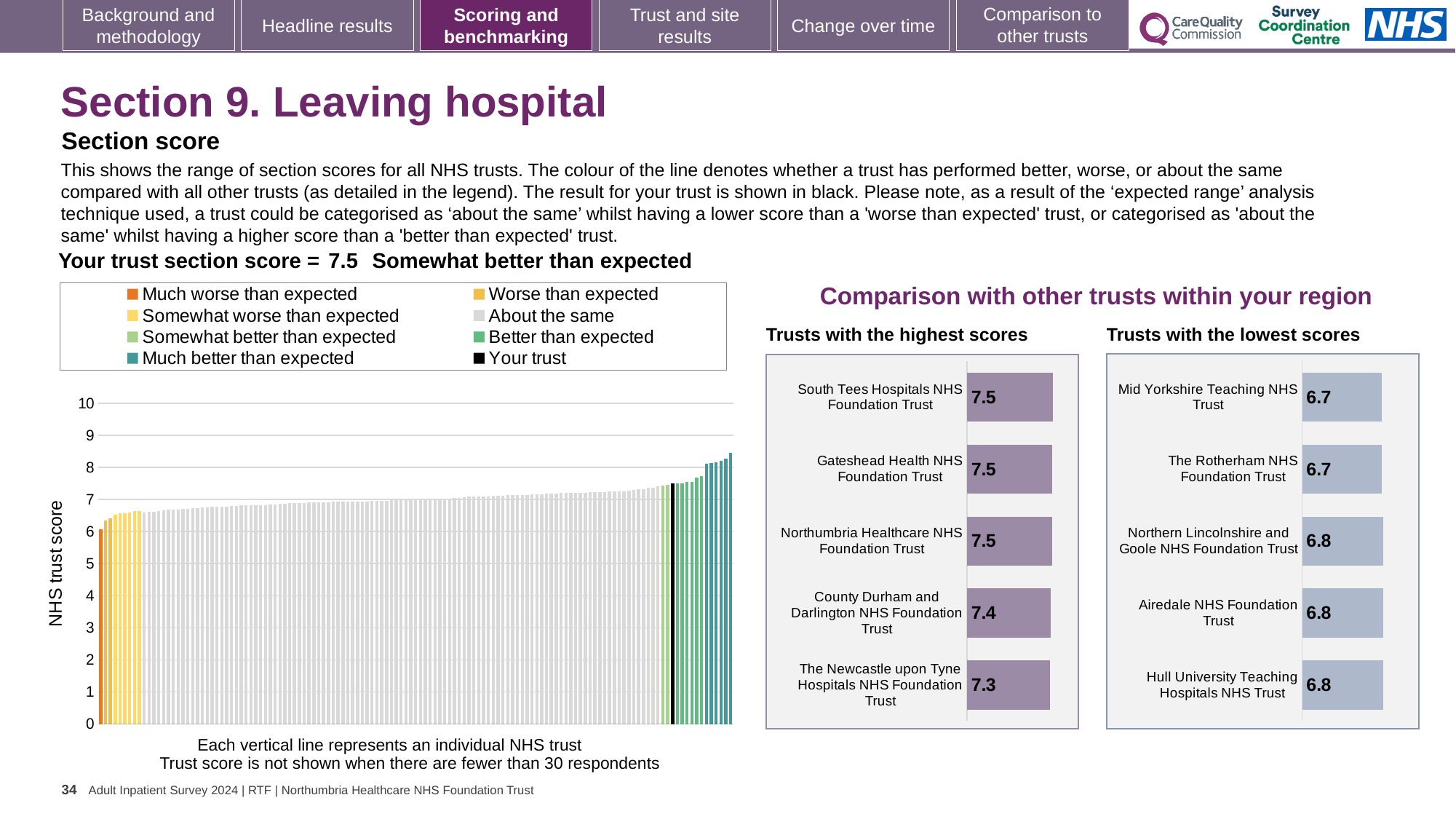
In the main NHS trust score chart on the left, is the score of the highest-scoring trust greater or less than 8? greater In the 'Trusts with the lowest scores' chart, what is the difference between the scores of Hull University Teaching Hospitals NHS Trust and The Rotherham NHS Foundation Trust? 0.1 How many trusts are shown in the 'Trusts with the lowest scores' chart? 5 In the 'Trusts with the lowest scores' chart, what is the score for Mid Yorkshire Teaching NHS Trust? 6.7 What kind of chart is the 'Trusts with the lowest scores' chart? bar chart In the 'Trusts with the highest scores' chart, what is the score for The Newcastle upon Tyne Hospitals NHS Foundation Trust? 7.3 In the 'Trusts with the lowest scores' chart, what is the score for Airedale NHS Foundation Trust? 6.8 In the 'Trusts with the highest scores' chart, what is the score for County Durham and Darlington NHS Foundation Trust? 7.4 In the 'Trusts with the highest scores' chart, which has the higher score: Gateshead Health NHS Foundation Trust or County Durham and Darlington NHS Foundation Trust? Gateshead Health NHS Foundation Trust In the 'Trusts with the highest scores' chart, which trust has the lowest score? The Newcastle upon Tyne Hospitals NHS Foundation Trust In the 'Trusts with the highest scores' chart, what is the difference between the scores of South Tees Hospitals NHS Foundation Trust and The Newcastle upon Tyne Hospitals NHS Foundation Trust? 0.2 How many trusts are shown in the 'Trusts with the highest scores' chart? 5